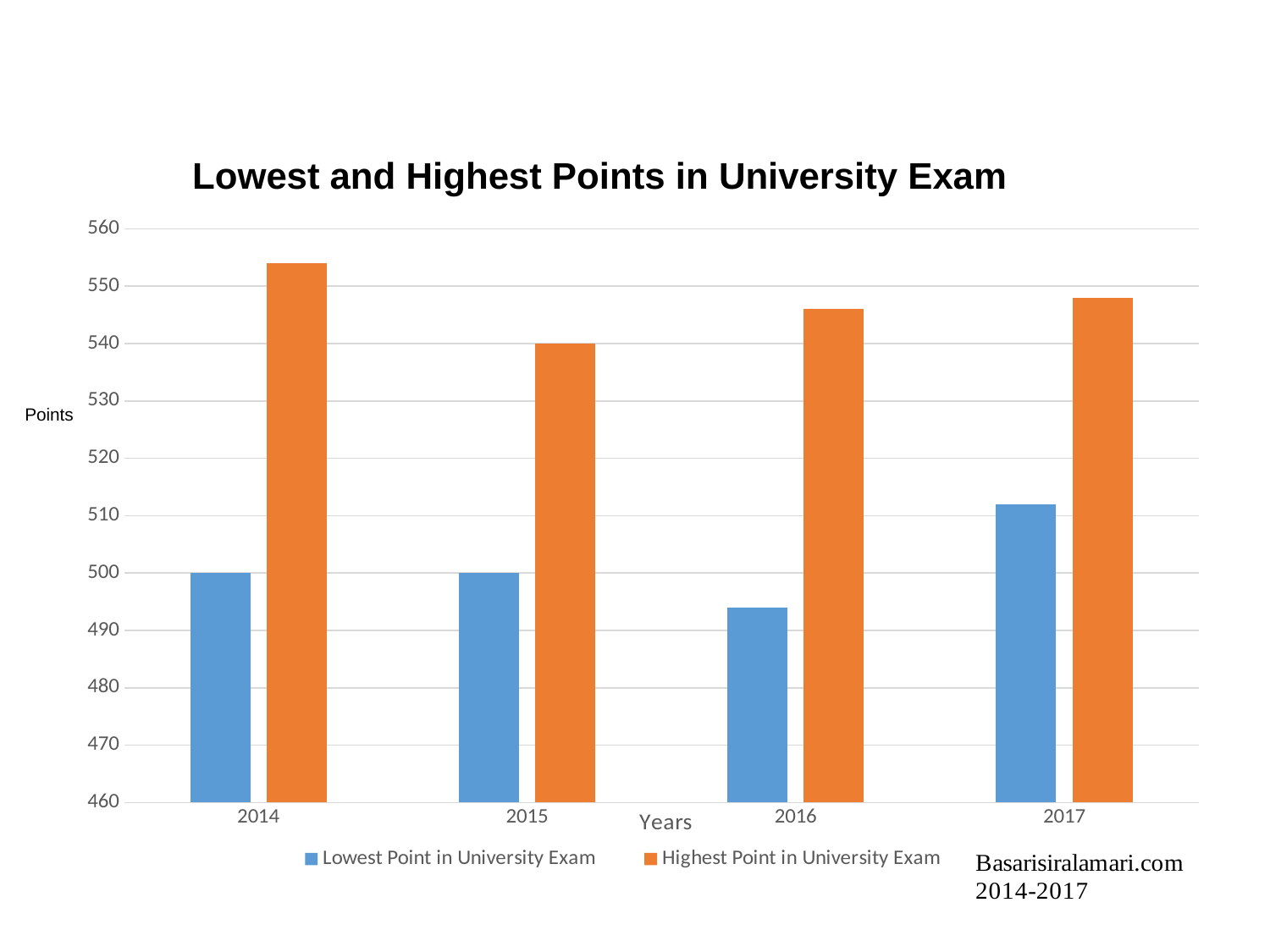
Is the Lowest Point in University Exam for 2016 greater or less than 500? less What is the Lowest Point in University Exam for 2014? 500 Which year has a larger Lowest Point in University Exam, 2016 or 2017? 2017 How many years are shown on the x axis? 4 Is the Lowest Point in University Exam for 2017 greater or less than 510? greater What type of chart is shown on the slide? Bar chart Is the Highest Point in University Exam for 2014 greater or less than 550? greater What is the Highest Point in University Exam for 2015? 540 How many series does the legend list? 2 What is the title of the chart? Lowest and Highest Points in University Exam Which year has the lowest value for Lowest Point in University Exam? 2016 Which year has the highest value for Highest Point in University Exam? 2014